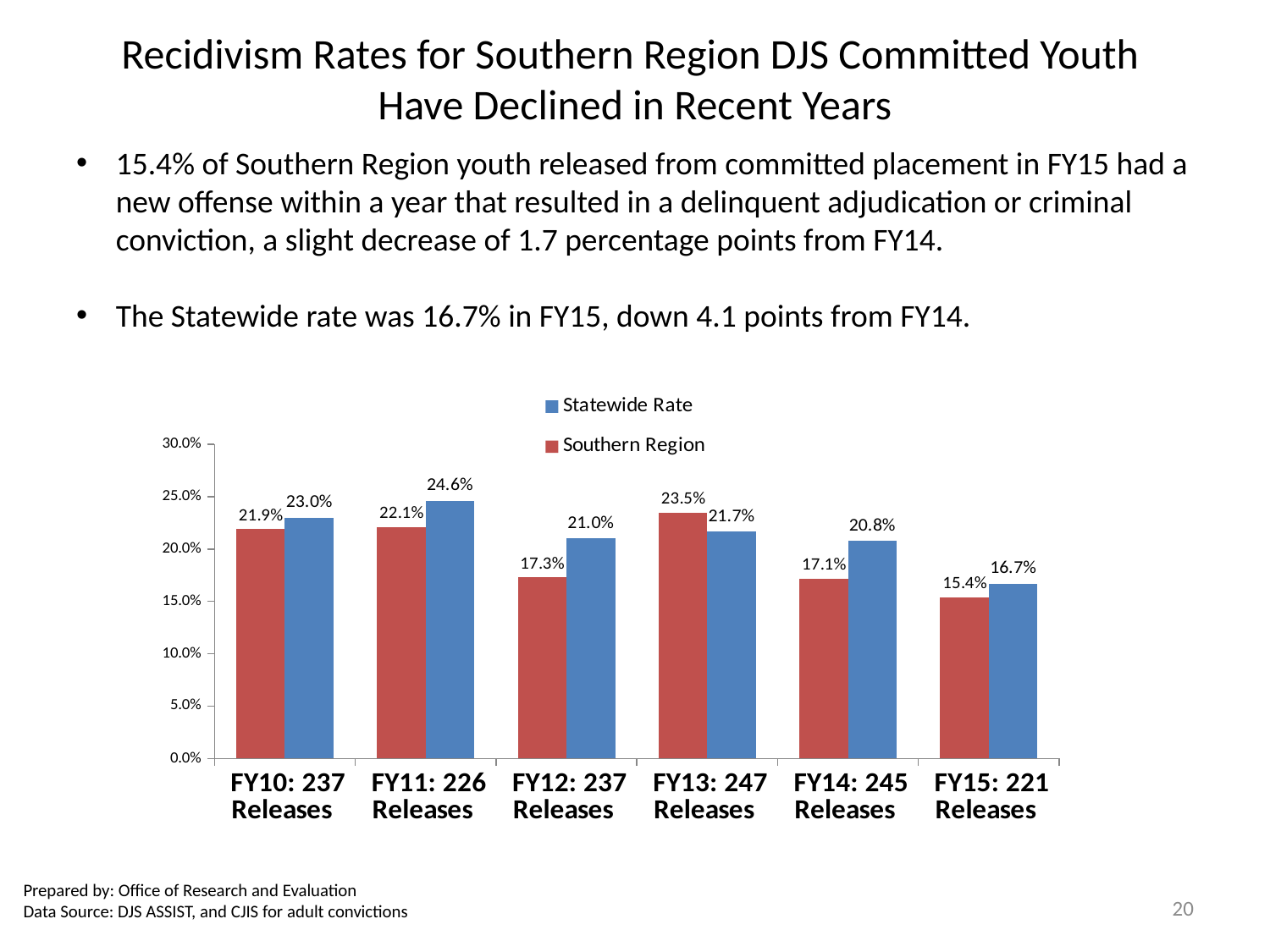
Which is larger for FY13: 247 Releases, the Southern Region rate or the Statewide Rate? Southern Region Does the Southern Region rate rise or fall from FY13: 247 Releases to FY15: 221 Releases? fall What is the difference between the Statewide Rate and the Southern Region rate for FY14: 245 Releases? 3.7% How many series does the legend list? 2 What is the Southern Region rate for FY13: 247 Releases? 23.5% What is the Southern Region rate for FY15: 221 Releases? 15.4% Is the Statewide Rate for FY12: 237 Releases greater or less than 20.0%? greater What kind of chart is shown on the slide? bar chart Which category has the lowest Southern Region rate? FY15: 221 Releases Which category has the highest Statewide Rate? FY11: 226 Releases How many fiscal year categories are shown on the x axis? 6 What is the Statewide Rate for FY11: 226 Releases? 24.6%